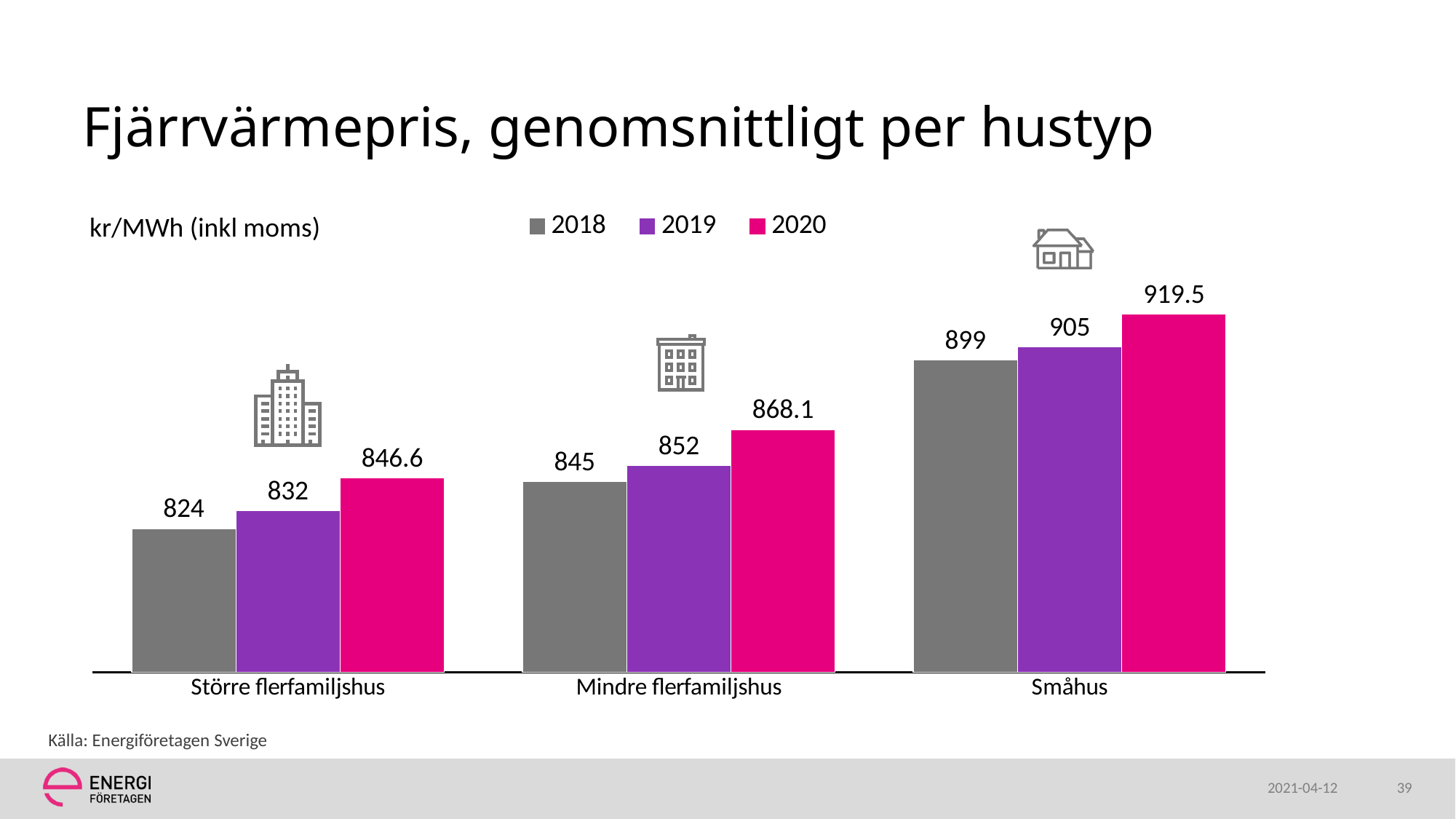
How many categories are shown on the x axis? 3 Which is larger: the 2020 value for Mindre flerfamiljshus or the 2018 value for Småhus? 2018 value for Småhus What is the difference between the 2020 and 2018 values for Småhus? 20.5 What is the 2020 value for Småhus? 919.5 Which category has the highest 2020 value? Småhus What is the 2018 value for Större flerfamiljshus? 824 What unit is stated for the values in the chart? kr/MWh (inkl moms) How many series does the legend list? 3 What is the difference between the 2019 values for Mindre flerfamiljshus and Större flerfamiljshus? 20 What is the 2019 value for Mindre flerfamiljshus? 852 Which category has the lowest 2018 value? Större flerfamiljshus What kind of chart is shown on the slide? Bar chart